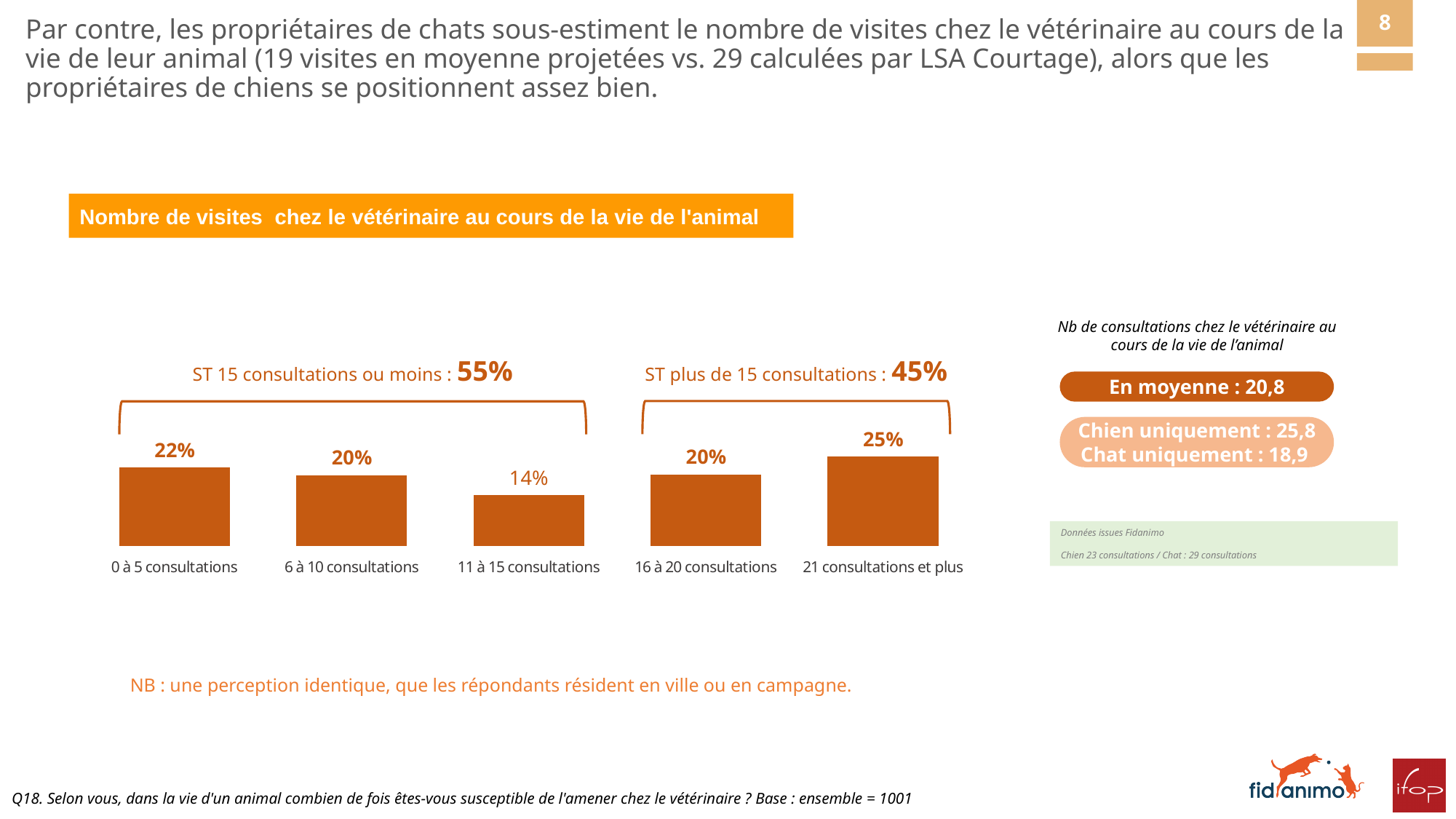
Which category has the lowest value? 11 à 15 consultations What is the value for "21 consultations et plus"? 25% What is the difference between the values for "0 à 5 consultations" and "6 à 10 consultations"? 2% Which is larger, the value for "0 à 5 consultations" or the value for "11 à 15 consultations"? 0 à 5 consultations What is the subtotal shown for "ST 15 consultations ou moins"? 55% What is the value for "16 à 20 consultations"? 20% What is the difference between the values for "21 consultations et plus" and "11 à 15 consultations"? 11% Which category has the highest value? 21 consultations et plus What is the value for "11 à 15 consultations"? 14% What is the value for "0 à 5 consultations"? 22% How many categories are shown in the chart? 5 What kind of chart is shown on the slide? Bar chart